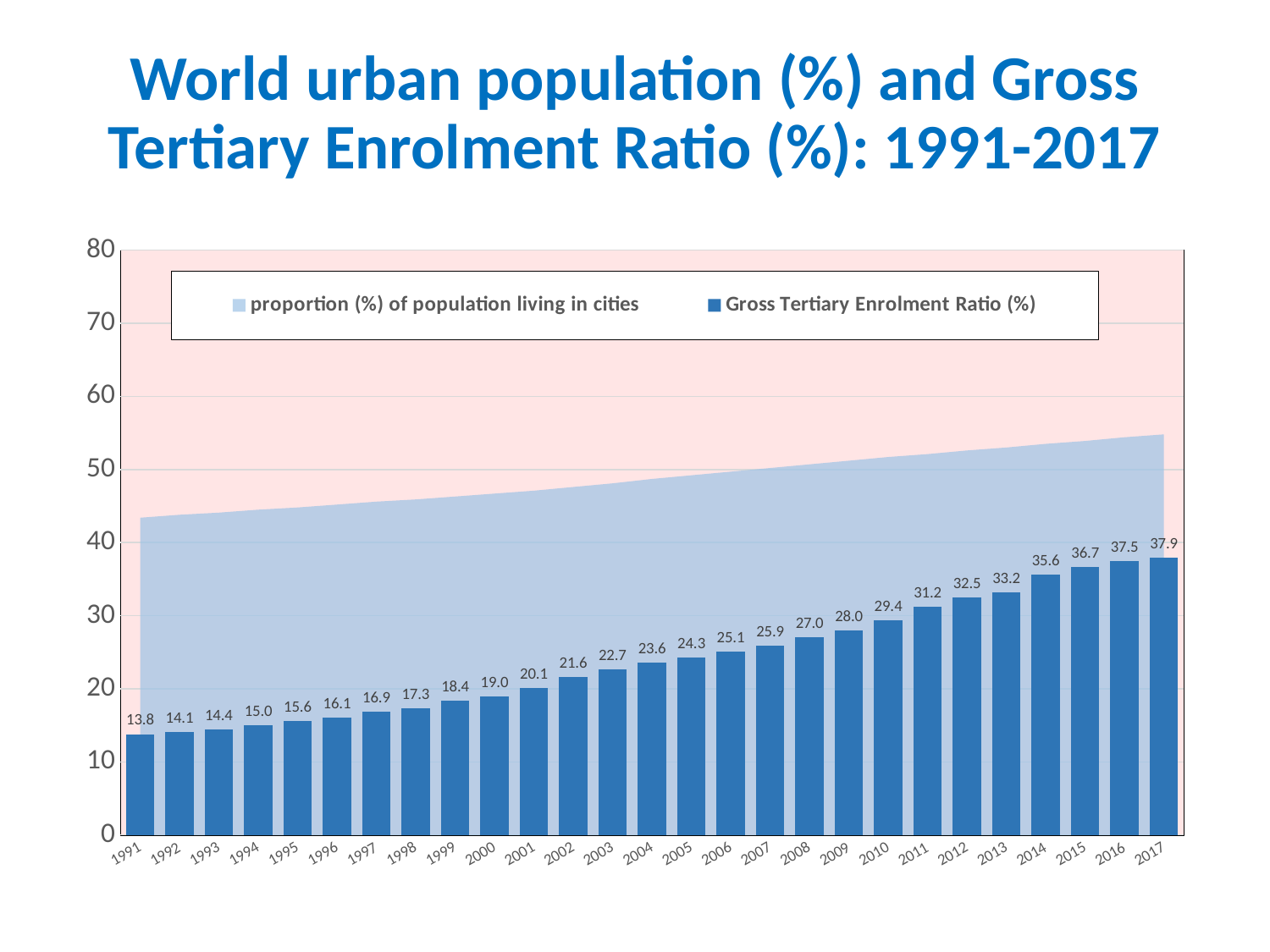
Which year has the lowest Gross Tertiary Enrolment Ratio (%)? 1991 What is the Gross Tertiary Enrolment Ratio (%) for 2017? 37.9 How many series does the legend list? 2 What is the Gross Tertiary Enrolment Ratio (%) for 1991? 13.8 Is the proportion (%) of population living in cities in 1991 greater or less than 40? greater Does the Gross Tertiary Enrolment Ratio (%) rise or fall from 1991 to 2017? rise Which year has a larger Gross Tertiary Enrolment Ratio (%), 2003 or 2008? 2008 What is the Gross Tertiary Enrolment Ratio (%) for 2005? 24.3 How many years are shown on the x axis? 27 What is the difference between the Gross Tertiary Enrolment Ratio (%) in 2017 and in 1991? 24.1 Is the proportion (%) of population living in cities in 2017 greater or less than 60? less Which year has the highest Gross Tertiary Enrolment Ratio (%)? 2017